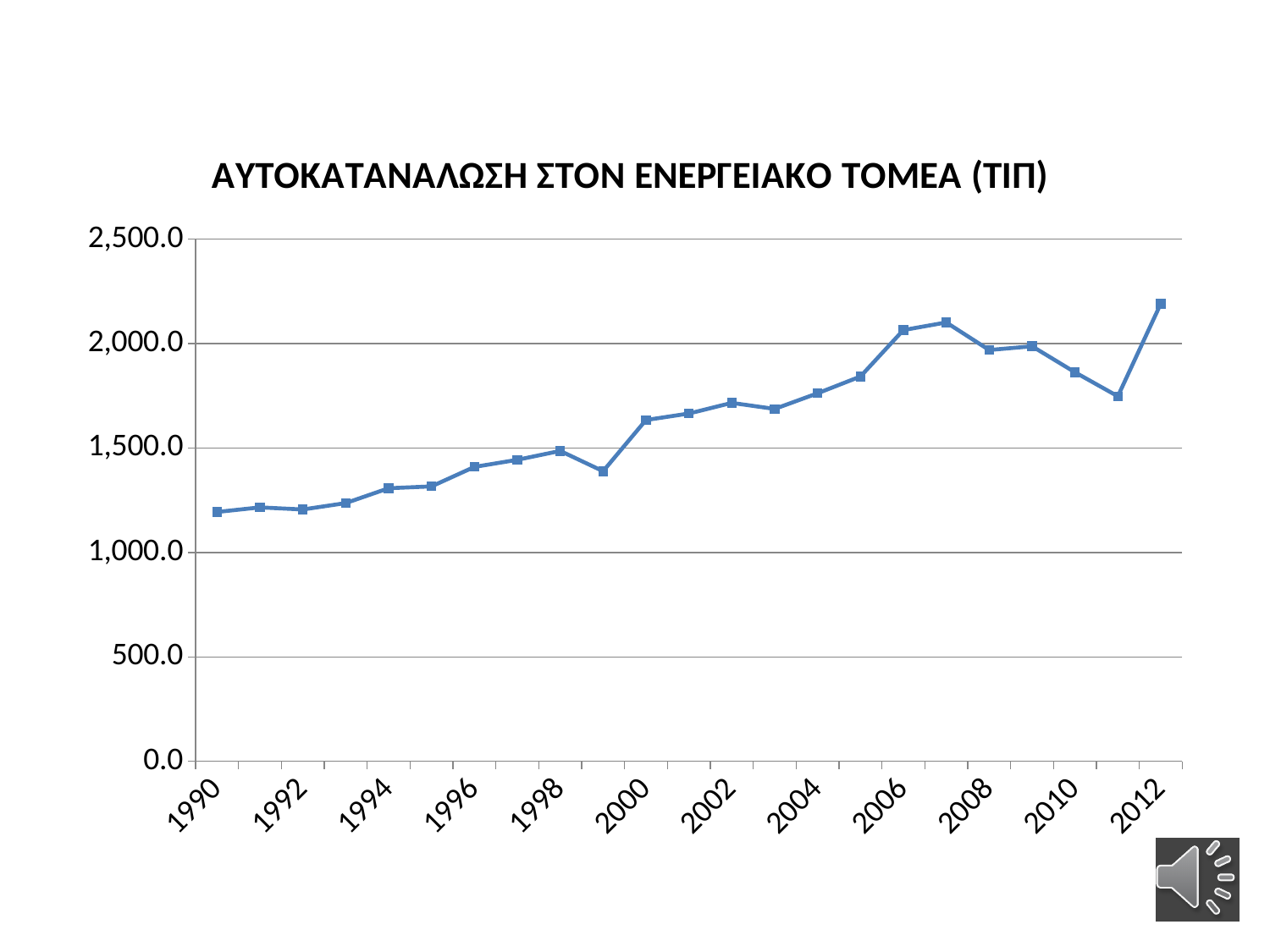
Is the value for 2011 greater or less than 2,000.0? less Is the value for 2000 greater or less than 1,500.0? greater Is the value for 2007 greater or less than 2,000.0? greater What is the title of the chart? ΑΥΤΟΚΑΤΑΝΑΛΩΣΗ ΣΤΟΝ ΕΝΕΡΓΕΙΑΚΟ ΤΟΜΕΑ (ΤΙΠ) What kind of chart is shown on the slide? line chart Which year has the larger value, 2007 or 2011? 2007 Which year has the larger value, 1999 or 2000? 2000 Which year has the highest value on the chart? 2012 Overall, do the values rise or fall from 1990 to 2012? rise How many data points are plotted on the line (years 1990 to 2012)? 23